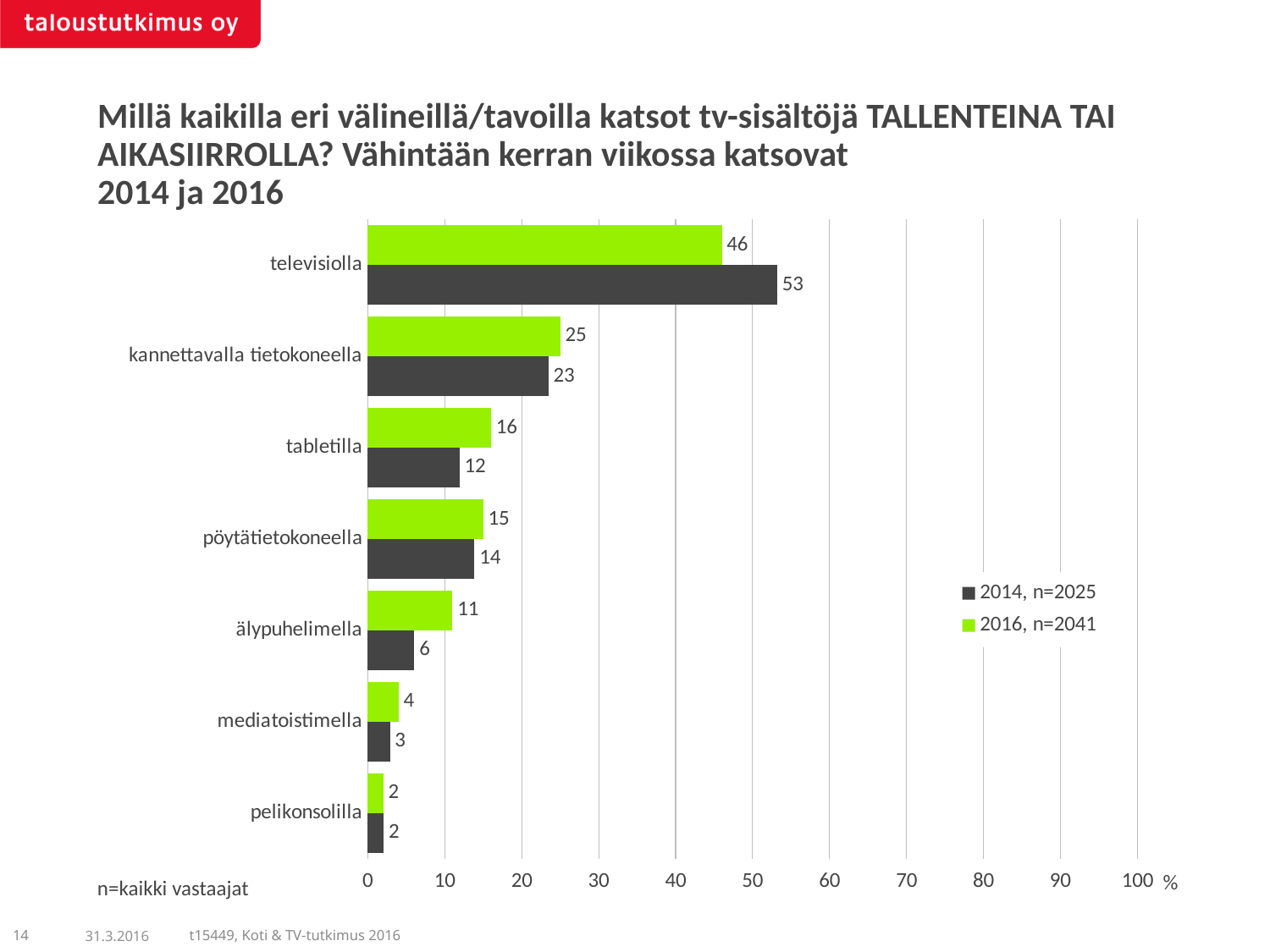
What is the value for älypuhelimella in the 2014, n=2025 series? 6 What is the value for tabletilla in the 2016, n=2041 series? 16 How many categories are shown on the chart? 7 Which category has the highest value in the 2014, n=2025 series? televisiolla Which is larger for kannettavalla tietokoneella: the 2014 value or the 2016 value? 2016 What is the value for televisiolla in the 2016, n=2041 series? 46 What colour are the bars for the 2016, n=2041 series? green What kind of chart is shown on the slide? bar chart Is the 2014 value for televisiolla greater or less than 50? greater How many series does the legend list? 2 What is the difference between the 2014 and 2016 values for televisiolla? 7 Which category has the lowest value in the 2016, n=2041 series? pelikonsolilla